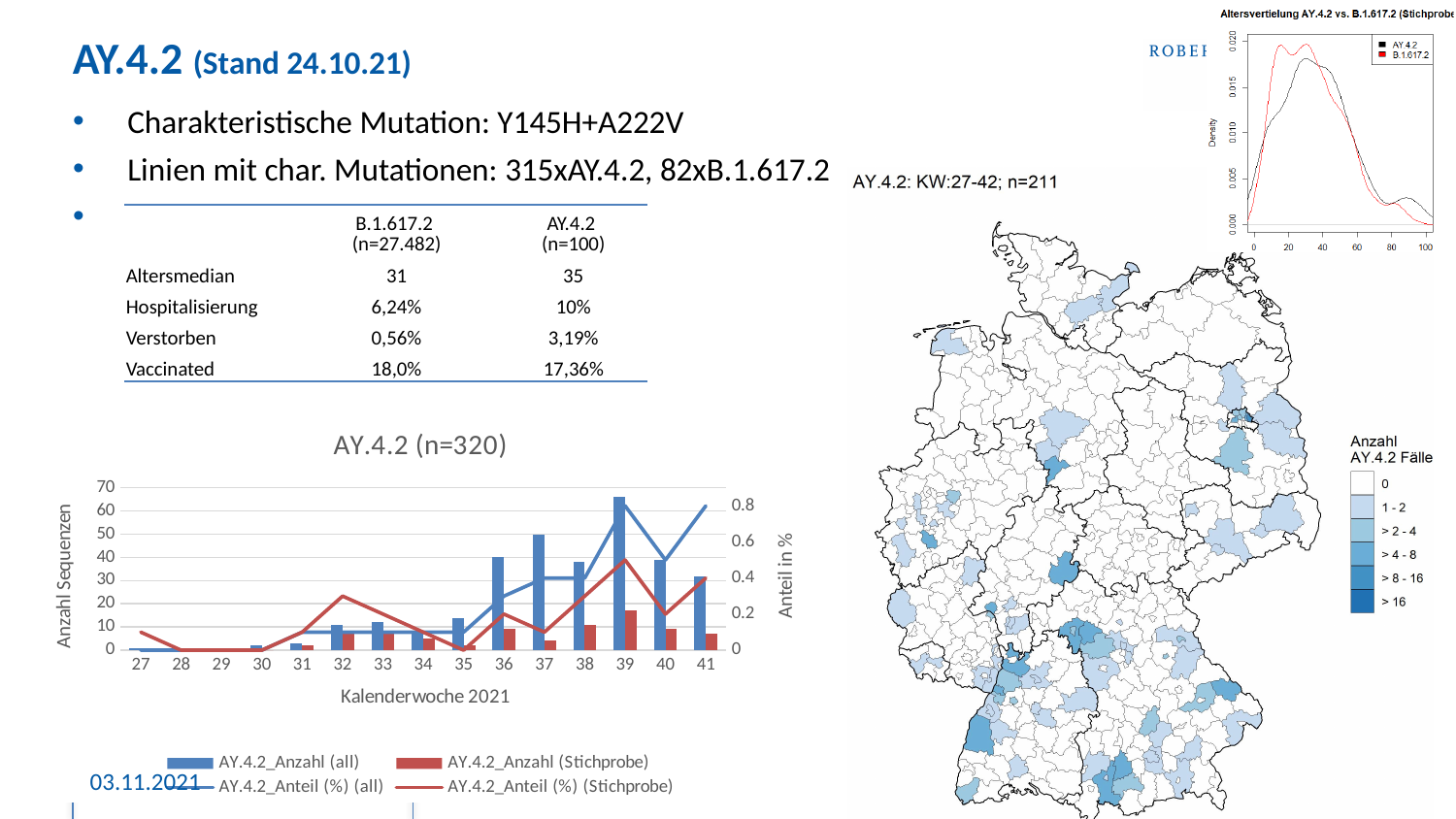
In the chart titled "AY.4.2 (n=320)", what kind of chart is it? A combined bar and line chart In the chart titled "AY.4.2 (n=320)", is the AY.4.2_Anzahl (Stichprobe) value for week 39 greater or less than 10? greater In the chart titled "AY.4.2 (n=320)", which has the larger AY.4.2_Anzahl (all) bar, week 37 or week 39? Week 39 In the chart titled "AY.4.2 (n=320)", which calendar week has the highest AY.4.2_Anzahl (all) bar? 39 In the chart titled "AY.4.2 (n=320)", is the AY.4.2_Anzahl (all) value for week 39 greater or less than 60? greater In the chart titled "AY.4.2 (n=320)", is the AY.4.2_Anzahl (all) value for week 37 greater or less than 40? greater In the chart titled "AY.4.2 (n=320)", what is the label of the x axis? Kalenderwoche 2021 In the chart titled "AY.4.2 (n=320)", do the AY.4.2_Anzahl (all) bars generally rise or fall from week 27 to week 39? Rise In the chart titled "AY.4.2 (n=320)", how many calendar weeks are shown on the x axis? 15 In the chart titled "AY.4.2 (n=320)", how many series does the legend list? 4 In the chart titled "AY.4.2 (n=320)", which has the larger AY.4.2_Anzahl (all) bar, week 35 or week 36? Week 36